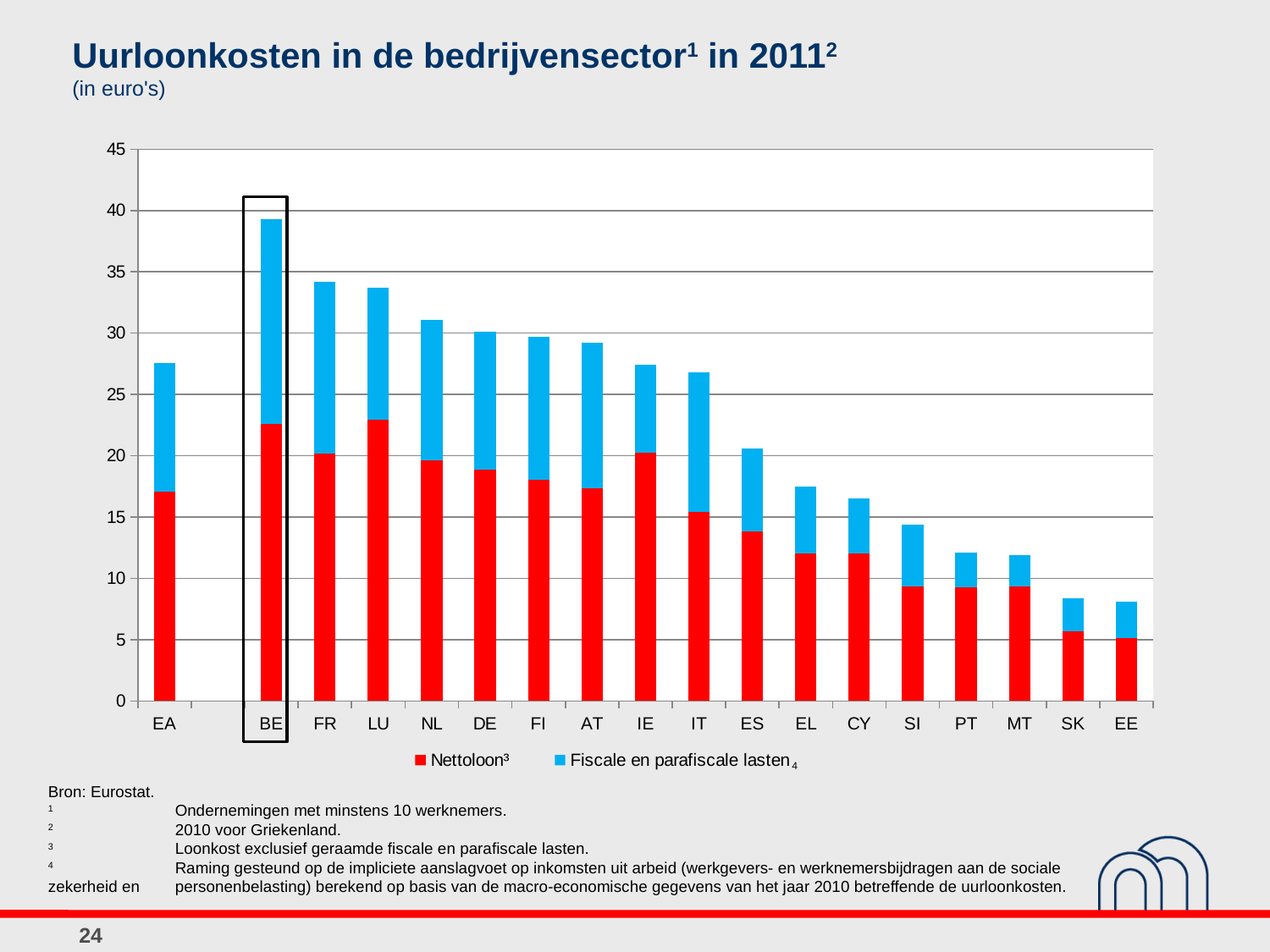
Which has the larger Nettoloon value, IE or IT? IE What kind of chart is shown on the slide? Stacked bar chart Which has the larger total bar, LU or NL? LU Which country has the highest total hourly labour cost in the chart? BE Is the total bar for FR greater or less than 30? greater How many series does the legend list? 2 Which series is shown in red in the chart? Nettoloon Do the total bar heights rise or fall moving from BE to EE along the x axis? Fall Is the Nettoloon value for IT greater or less than 20? less Is the total bar for BE greater or less than 35? greater How many countries/regions are shown on the x axis of the chart? 18